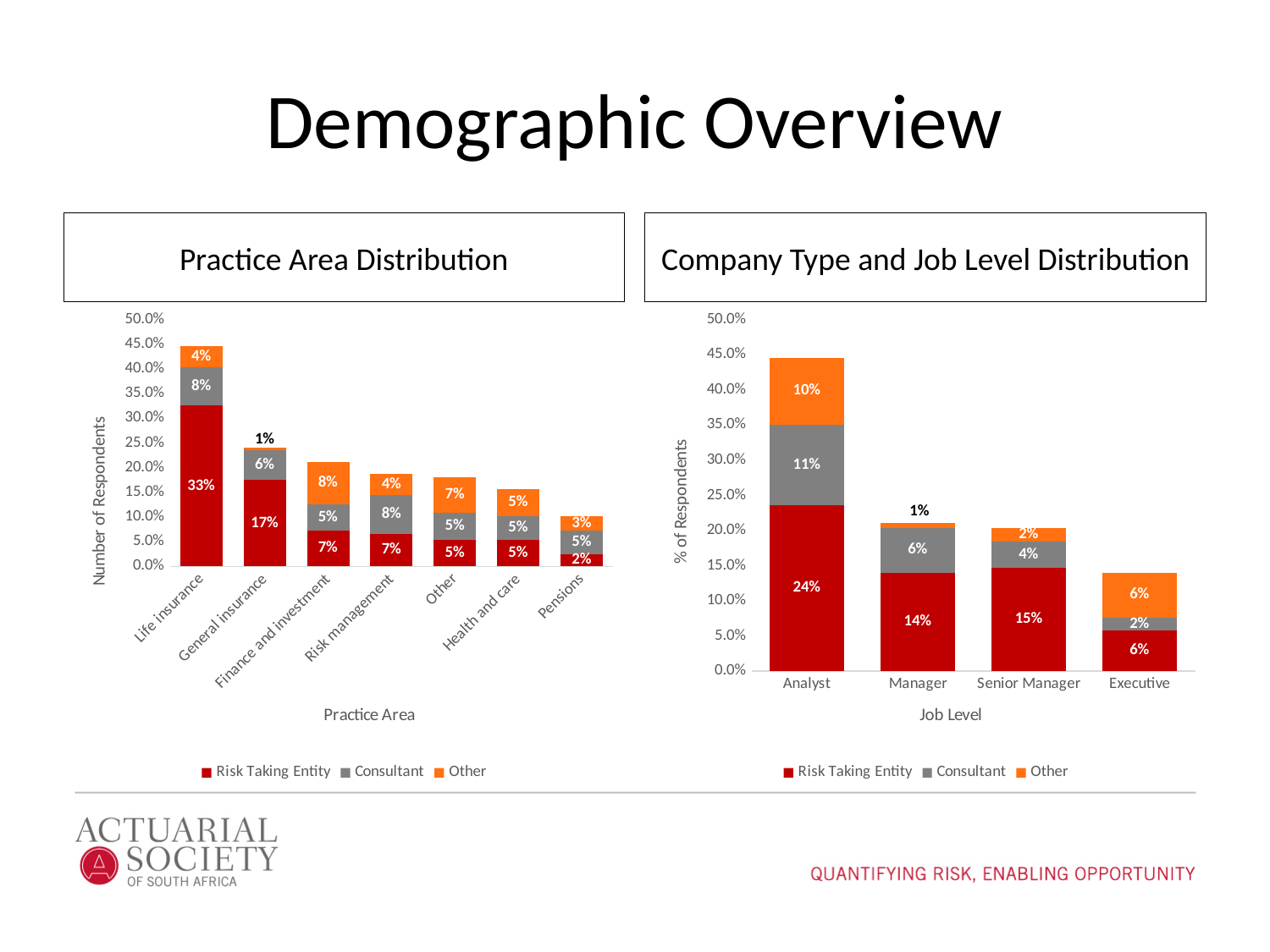
How many series does the legend of the Company Type and Job Level Distribution chart list? 3 In the Practice Area Distribution chart, what is the difference between the Risk Taking Entity values for Life insurance and General insurance? 16 percentage points In the Practice Area Distribution chart, which practice area has the shortest stacked bar? Pensions In the Company Type and Job Level Distribution chart, what is the Consultant value for Analyst? 11% In the Company Type and Job Level Distribution chart, is the total stacked bar for Analyst greater or less than 40.0%? greater How many practice areas are shown on the x axis of the Practice Area Distribution chart? 7 In the Practice Area Distribution chart, which has the larger Other value: Finance and investment or Risk management? Finance and investment In the Practice Area Distribution chart, which practice area has the tallest stacked bar? Life insurance In the Company Type and Job Level Distribution chart, what is the Other value for Executive? 6% In the Practice Area Distribution chart, what is the Risk Taking Entity value for Life insurance? 33% In the Company Type and Job Level Distribution chart, which job level has the shortest stacked bar? Executive In the Company Type and Job Level Distribution chart, which job level has the tallest stacked bar? Analyst